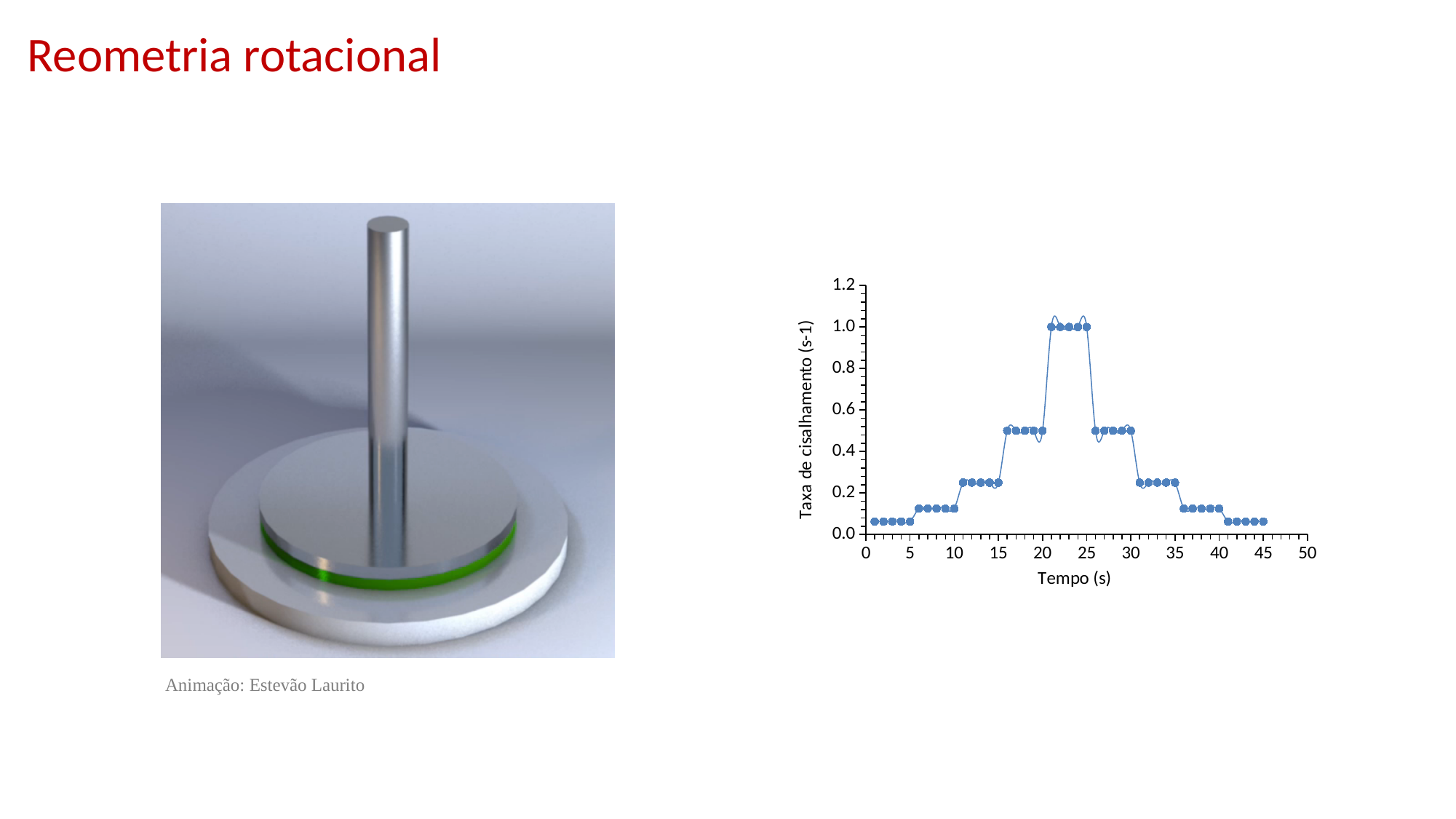
Is the value of Taxa de cisalhamento at Tempo = 23 s greater or less than 0.8? greater What is the title of the x axis of the chart? Tempo (s) What kind of chart is shown on the slide? line chart with markers How does Taxa de cisalhamento change as Tempo increases from 0 to 45 s? rises in steps to a peak, then falls in steps Is the value of Taxa de cisalhamento at Tempo = 17 s greater or less than 0.4? greater Is the value of Taxa de cisalhamento at Tempo = 12 s greater or less than 0.4? less What is the value of Taxa de cisalhamento at Tempo = 22 s? 1.0 Which is larger: the value of Taxa de cisalhamento at Tempo = 18 s or at Tempo = 33 s? Tempo = 18 s What is the title of the y axis of the chart? Taxa de cisalhamento (s-1) What is the highest value of Taxa de cisalhamento reached in the chart? 1.0